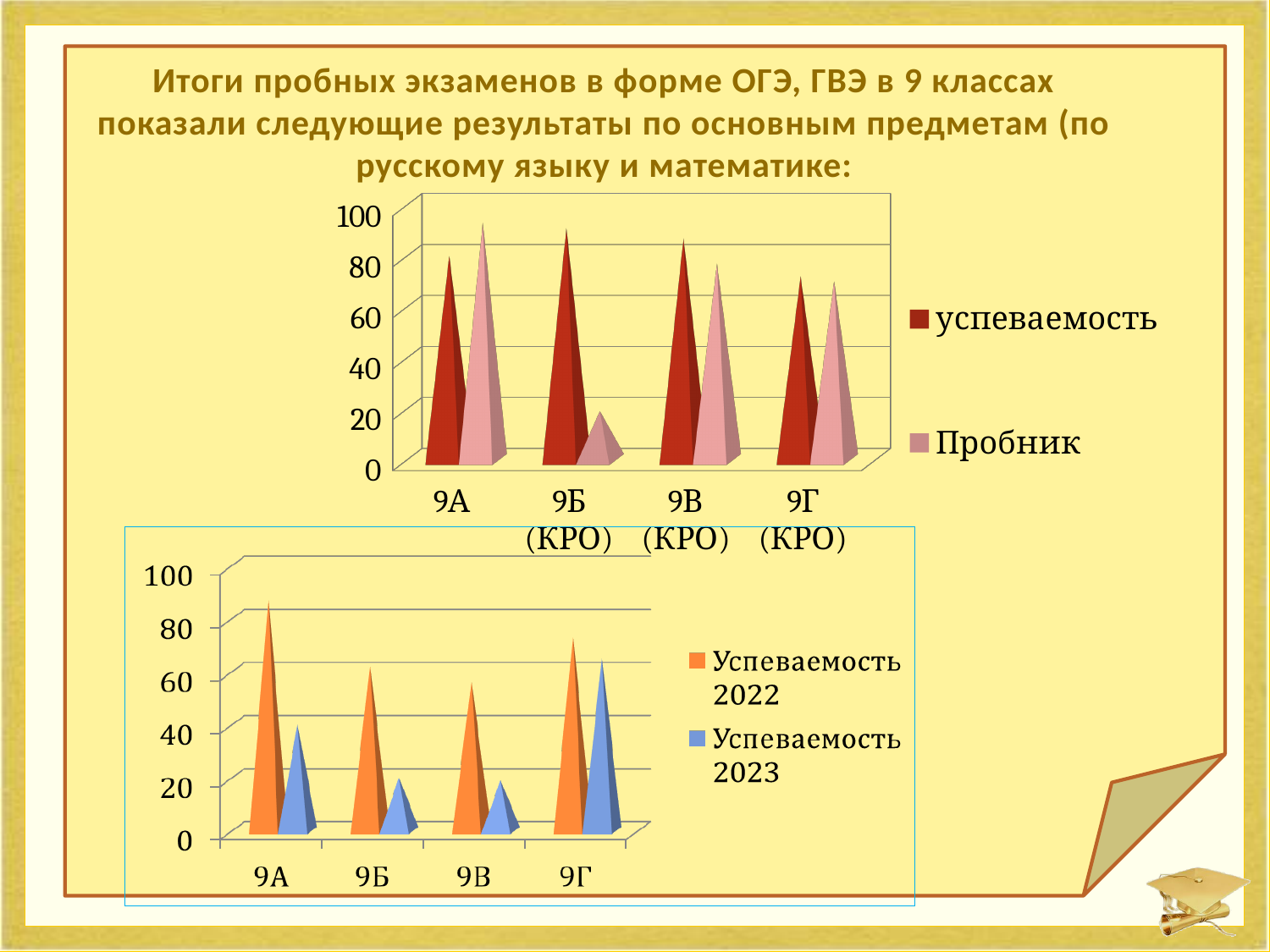
In the bottom chart, which category has the highest value for Успеваемость 2023? 9Г How many series does the legend of the top chart list? 2 In the bottom chart, which category has the highest value for Успеваемость 2022? 9А In the top chart, which category has the lowest value for Пробник? 9Б (КРО) In the bottom chart, for 9А, which is larger: Успеваемость 2022 or Успеваемость 2023? Успеваемость 2022 What kind of chart is the top chart on the slide? bar chart In the top chart, is the value of Пробник for 9Б (КРО) greater or less than 40? less In the top chart, for 9Б (КРО), which is larger: успеваемость or Пробник? успеваемость In the bottom chart, how many series does the legend list? 2 In the top chart, which category has the highest value for Пробник? 9А In the bottom chart, is the value of Успеваемость 2023 for 9А greater or less than 60? less How many categories are shown on the x axis of the top chart? 4